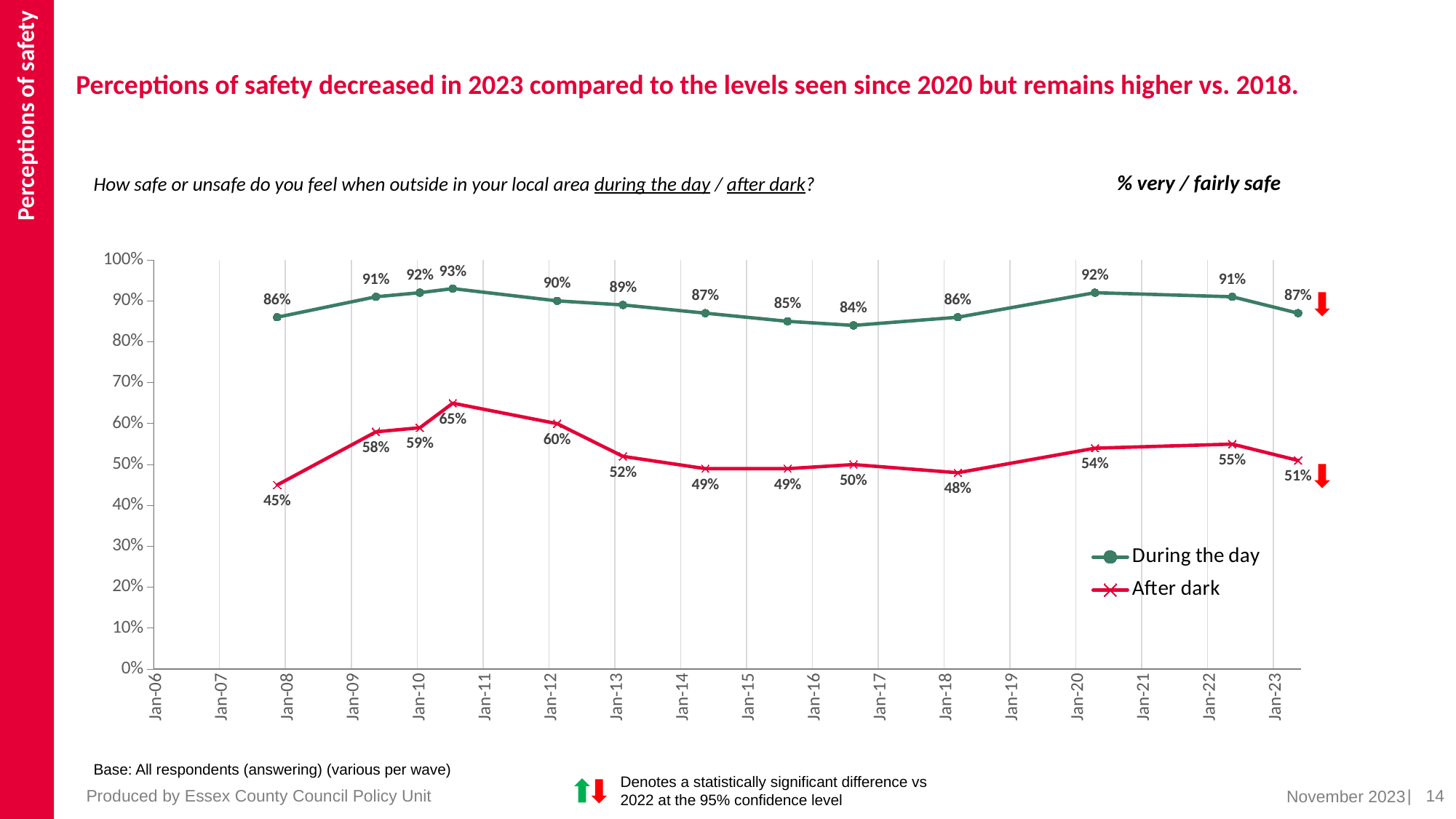
What is the most recent (rightmost) value for the 'During the day' series? 87% Which two series are listed in the chart legend? During the day; After dark How many data points are plotted for the 'After dark' series? 13 What is the most recent (rightmost) value for the 'After dark' series? 51% What kind of chart is shown on the slide? line chart What is the lowest value plotted for the 'During the day' series? 84% What is the lowest value plotted for the 'After dark' series? 45% What is the highest value plotted for the 'During the day' series? 93% What is the difference between the most recent 'During the day' value and the most recent 'After dark' value? 36 percentage points At the first plotted point, which series has the larger value, 'During the day' or 'After dark'? During the day How many series does the legend list? 2 What is the highest value plotted for the 'After dark' series? 65%